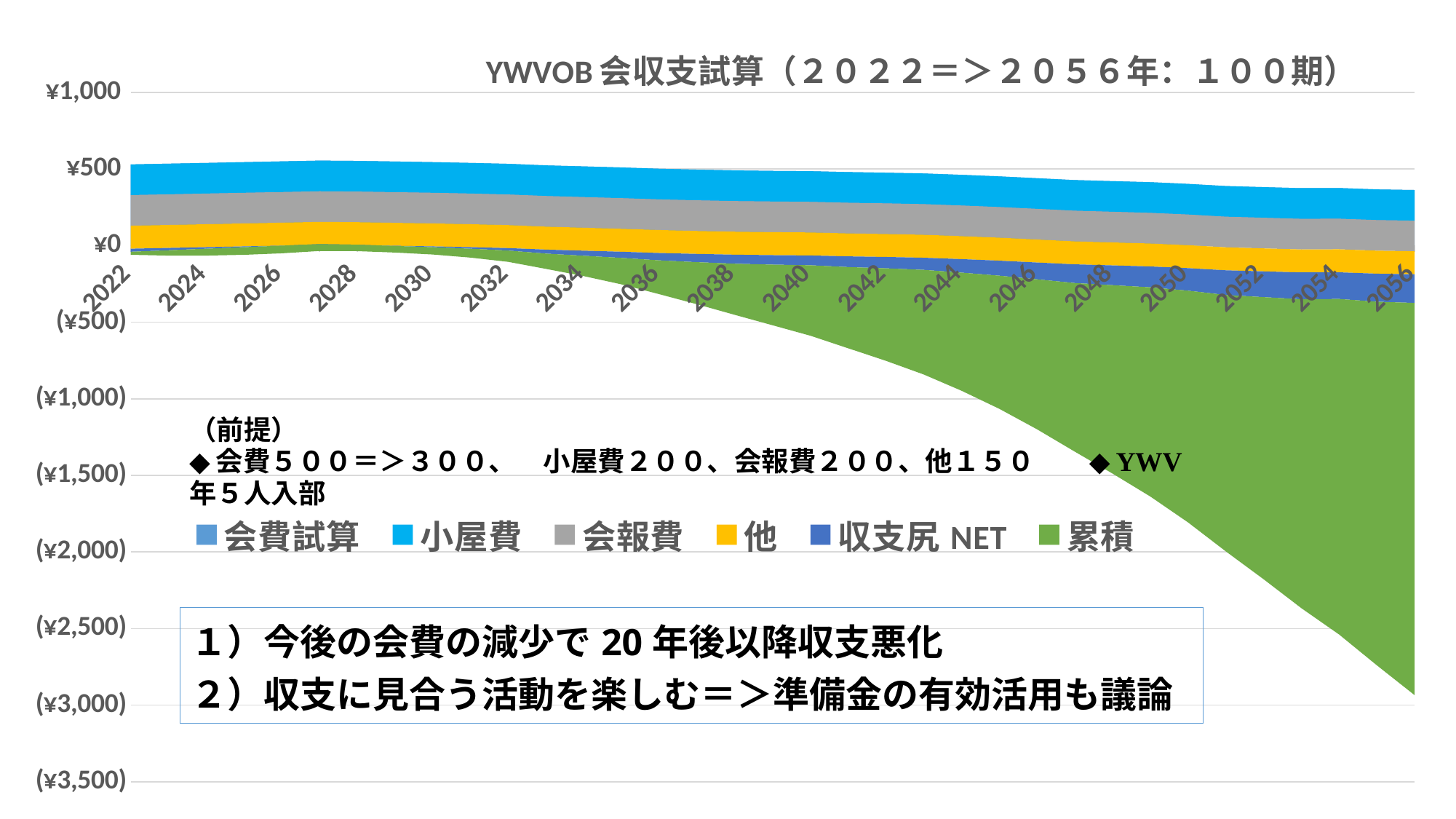
What is the lowest value shown on the y axis? (¥3,500) What is the highest value shown on the y axis? ¥1,000 Which series is shown in green in the legend? 累積 What is the title of the chart? YWVOB 会収支試算（２０２２＝＞２０５６年：１００期） What kind of chart is shown on the slide? Stacked area chart How many series does the legend list? 6 Does the 累積 (cumulative) series rise or fall from 2022 to 2056? Fall Is the value of the 累積 series in 2056 greater or less than (¥3,500)? greater Is the value of the 累積 series in 2056 greater or less than (¥2,500)? less How many year labels are shown along the x axis? 18 What is the first year shown on the x axis? 2022 What is the last year shown on the x axis? 2056